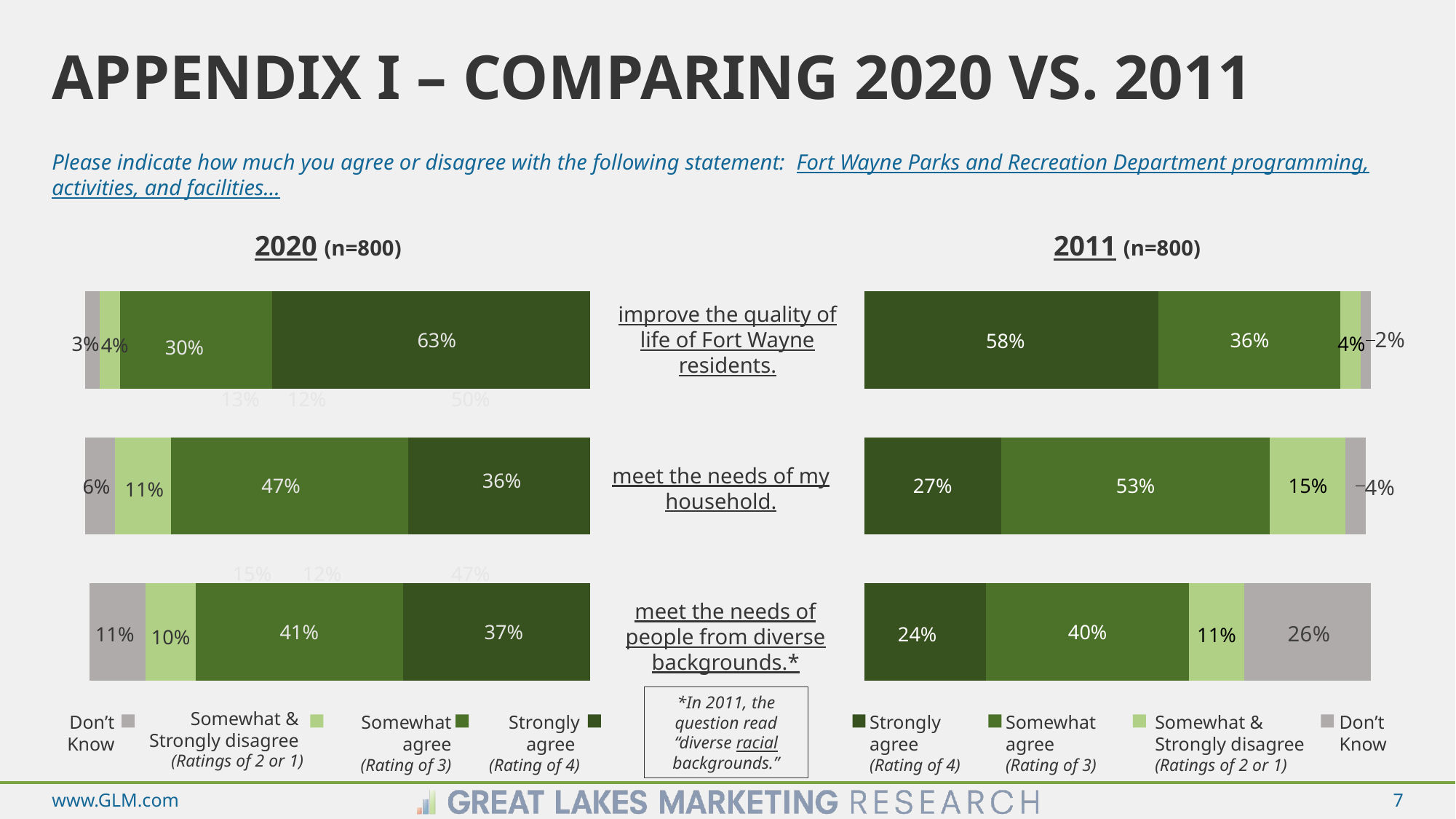
In the 2011 chart, which statement has the lowest Strongly agree percentage? meet the needs of people from diverse backgrounds.* What is the difference between the 2020 and 2011 Strongly agree percentages for the statement about improving the quality of life of Fort Wayne residents? 5 percentage points For the statement about meeting the needs of my household, is the Somewhat agree percentage larger in the 2020 chart or the 2011 chart? 2011 In the 2020 chart, what percentage answered Don't Know for the statement about meeting the needs of people from diverse backgrounds? 11% What type of chart is used for the 2020 (n=800) data? Stacked horizontal bar chart How many series does the legend of the 2020 chart list? 4 How many statements are shown in the 2011 chart? 3 In the 2011 chart, what percentage answered Don't Know for the statement about meeting the needs of people from diverse backgrounds? 26% In the 2011 chart, what percentage somewhat agree that the department meets the needs of my household? 53% In the 2020 chart, which statement has the highest Strongly agree percentage? improve the quality of life of Fort Wayne residents. In the 2020 chart, what percentage strongly agree that Fort Wayne Parks and Recreation programming improves the quality of life of Fort Wayne residents? 63% In the 2020 chart, what is the combined percentage of Somewhat agree and Strongly agree for the statement about meeting the needs of my household? 83%